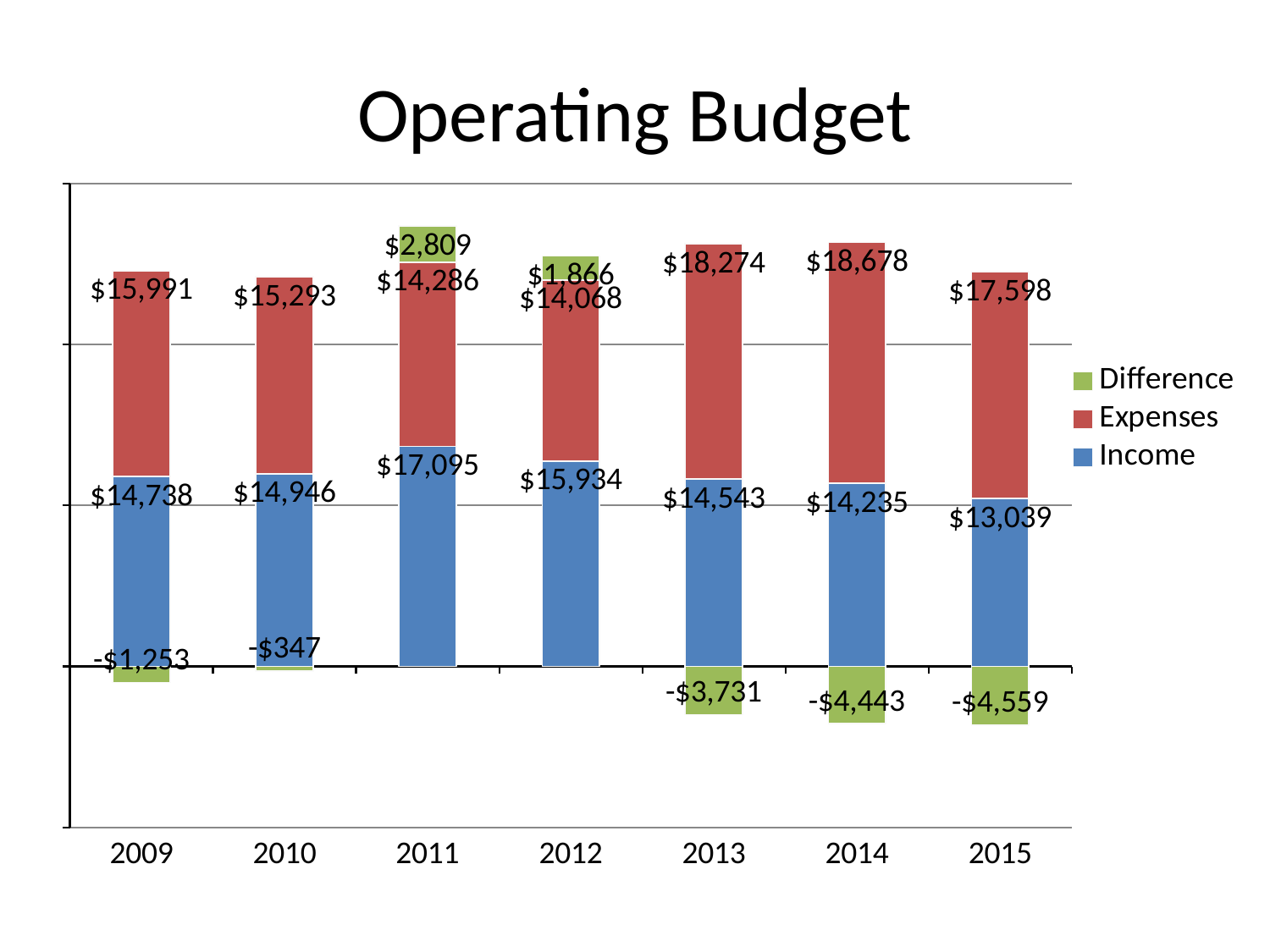
What is the Difference value for 2013? -$3,731 What is the difference between Expenses and Income in 2009? $1,253 What kind of chart is shown on the slide? Stacked bar chart Which year has the lowest Income value? 2015 What is the Income value for 2015? $13,039 What is the Income value for 2011? $17,095 How many series does the legend list? 3 Which year has the highest Income value? 2011 Is the Income value for 2012 larger or smaller than the Expenses value for 2012? larger How many years are shown on the x axis? 7 What is the Expenses value for 2014? $18,678 Which year has the highest Expenses value? 2014